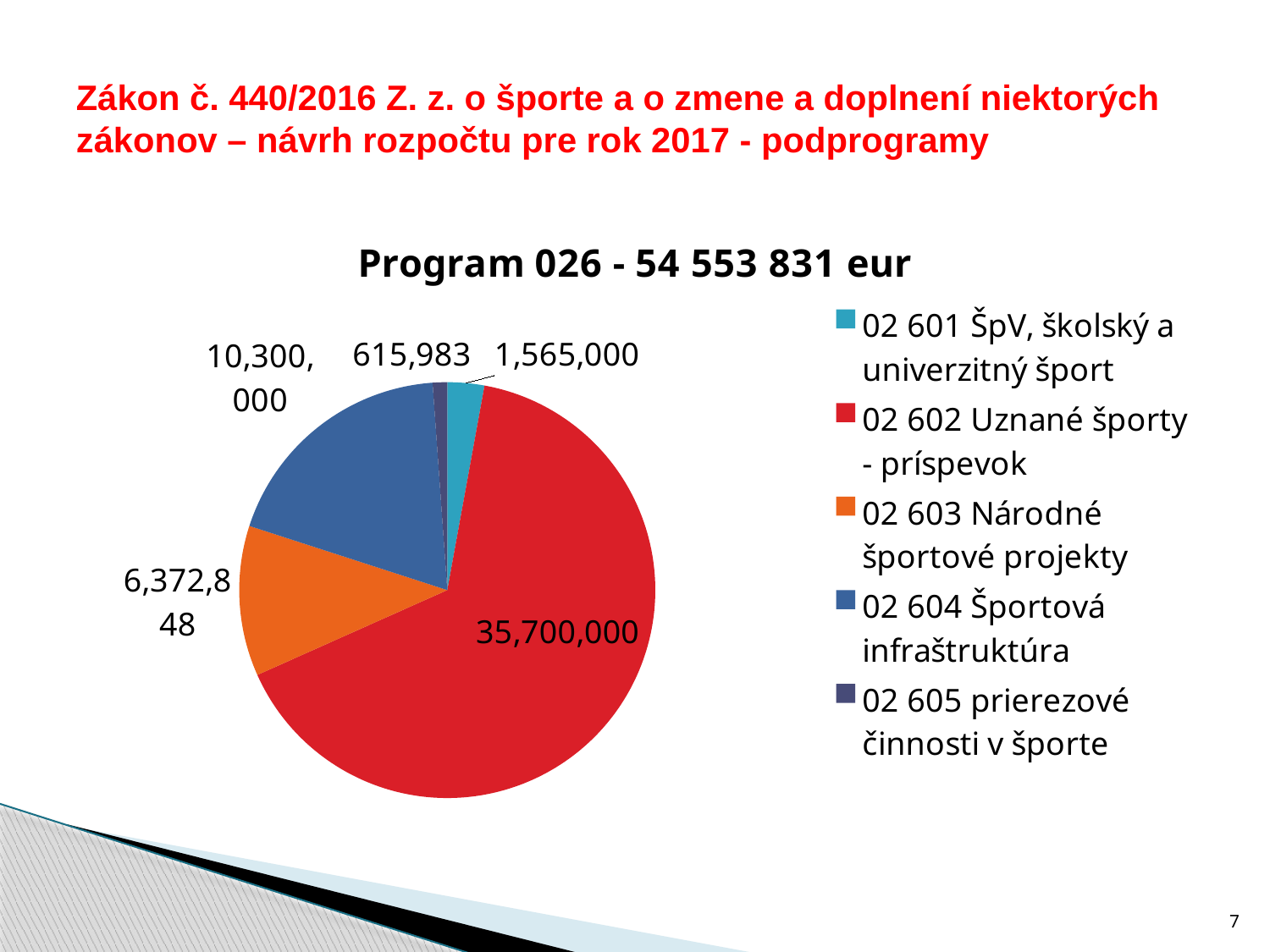
Which subprogram has the smallest slice of the pie? 02 605 prierezové činnosti v športe What type of chart is shown on the slide? Pie chart What is the value for 02 602 Uznané športy - príspevok? 35,700,000 How many entries does the legend list? 5 What is the title of the chart? Program 026 - 54 553 831 eur What is the value for 02 604 Športová infraštruktúra? 10,300,000 What is the difference between the values for 02 602 Uznané športy - príspevok and 02 604 Športová infraštruktúra? 25,400,000 How many slices does the pie chart have? 5 What is the value for 02 605 prierezové činnosti v športe? 615,983 Which subprogram has the largest slice of the pie? 02 602 Uznané športy - príspevok Which is larger, the value for 02 601 ŠpV, školský a univerzitný šport or the value for 02 603 Národné športové projekty? 02 603 Národné športové projekty What is the value for 02 603 Národné športové projekty? 6,372,848